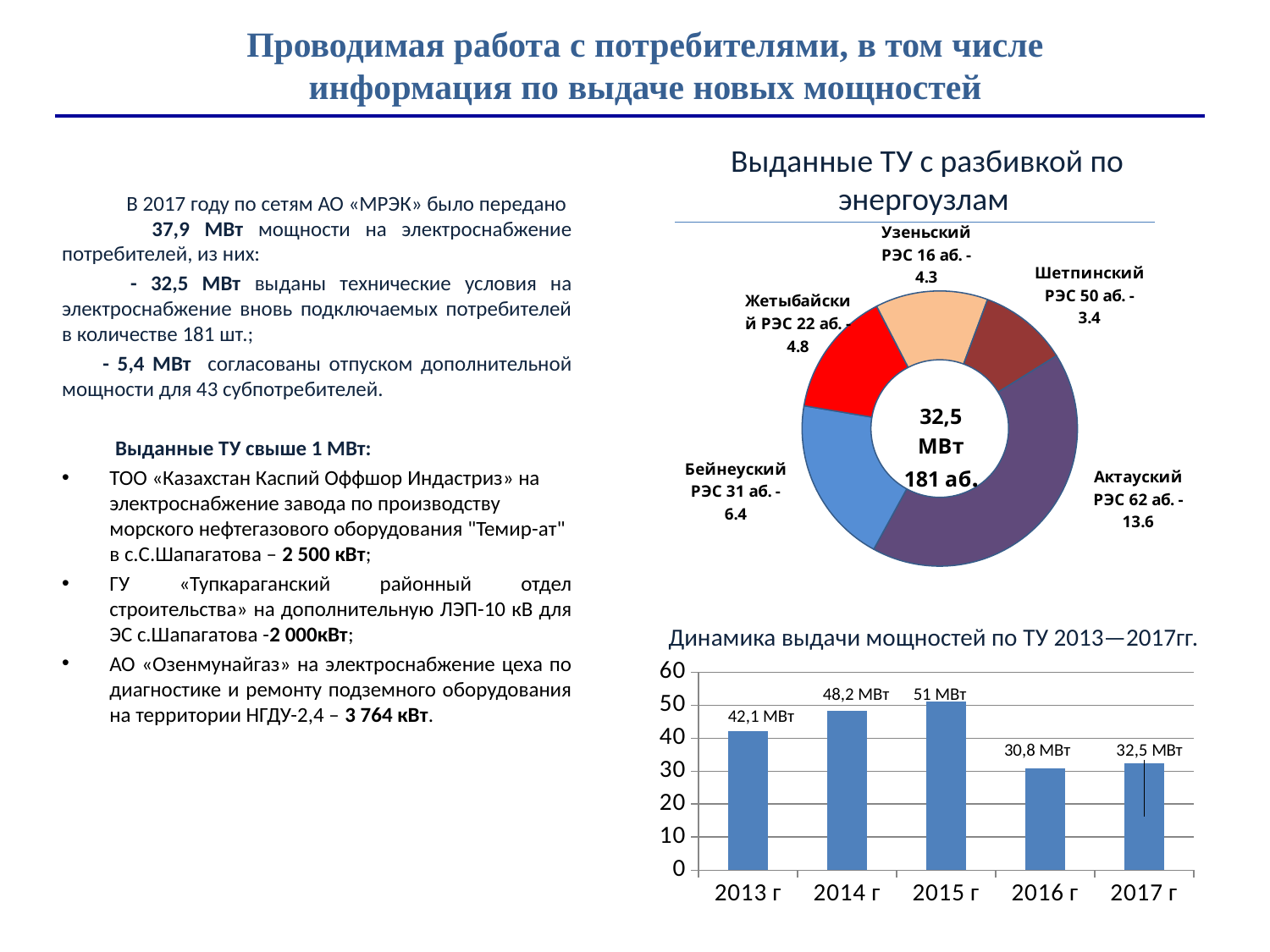
In the chart 'Динамика выдачи мощностей по ТУ 2013—2017гг.', what is the difference between the values for 2014 г and 2013 г? 6,1 МВт In the chart 'Выданные ТУ с разбивкой по энергоузлам', what total is printed in the centre of the doughnut? 32,5 МВт 181 аб. In the chart 'Динамика выдачи мощностей по ТУ 2013—2017гг.', what is the value for 2015 г? 51 МВт In the chart 'Динамика выдачи мощностей по ТУ 2013—2017гг.', how many years are shown on the x axis? 5 What kind of chart is 'Динамика выдачи мощностей по ТУ 2013—2017гг.'? Bar chart In the chart 'Динамика выдачи мощностей по ТУ 2013—2017гг.', what is the value for 2016 г? 30,8 МВт In the chart 'Выданные ТУ с разбивкой по энергоузлам', what value is shown for Актауский РЭС? 13.6 In the chart 'Динамика выдачи мощностей по ТУ 2013—2017гг.', which is larger: the value for 2017 г or 2016 г? 2017 г In the chart 'Динамика выдачи мощностей по ТУ 2013—2017гг.', which year has the highest value? 2015 г In the chart 'Динамика выдачи мощностей по ТУ 2013—2017гг.', which year has the lowest value? 2016 г In the chart 'Выданные ТУ с разбивкой по энергоузлам', which energy node has the largest slice? Актауский РЭС In the chart 'Выданные ТУ с разбивкой по энергоузлам', which energy node has the smallest slice? Шетпинский РЭС